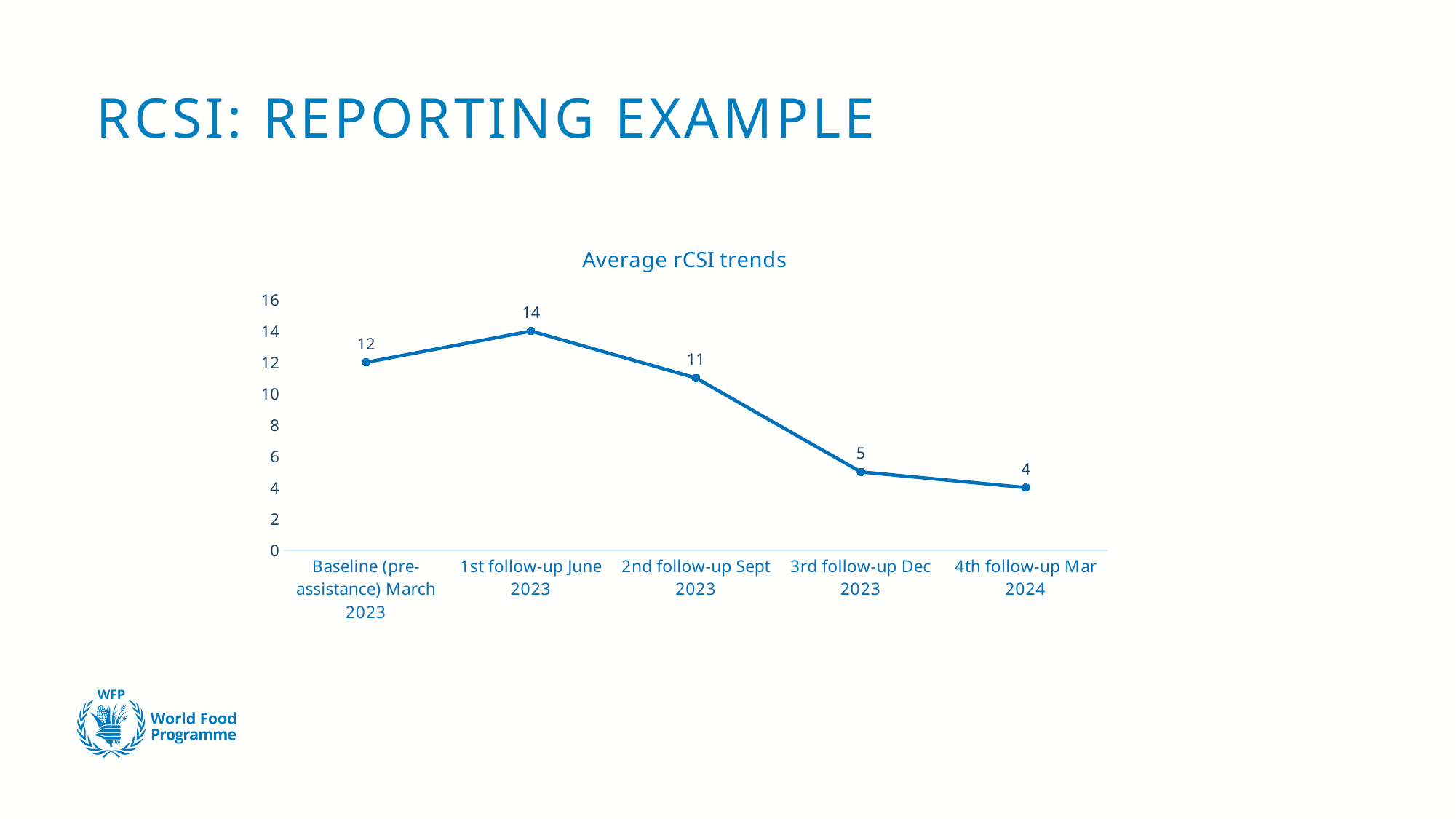
What is the average rCSI value at the 1st follow-up June 2023? 14 Which is larger, the average rCSI at the 2nd follow-up Sept 2023 or at the 3rd follow-up Dec 2023? 2nd follow-up Sept 2023 How many data points are plotted on the chart? 5 Which data point has the highest average rCSI value? 1st follow-up June 2023 What is the average rCSI value at the Baseline (pre-assistance) March 2023? 12 Is the average rCSI value at the 3rd follow-up Dec 2023 greater or less than 8? less What is the difference between the average rCSI at the 1st follow-up June 2023 and the 4th follow-up Mar 2024? 10 Which data point has the lowest average rCSI value? 4th follow-up Mar 2024 From the 1st follow-up June 2023 to the 4th follow-up Mar 2024, do the average rCSI values rise or fall? fall What is the title of the chart? Average rCSI trends What is the average rCSI value at the 4th follow-up Mar 2024? 4 What kind of chart is shown on the slide? line chart